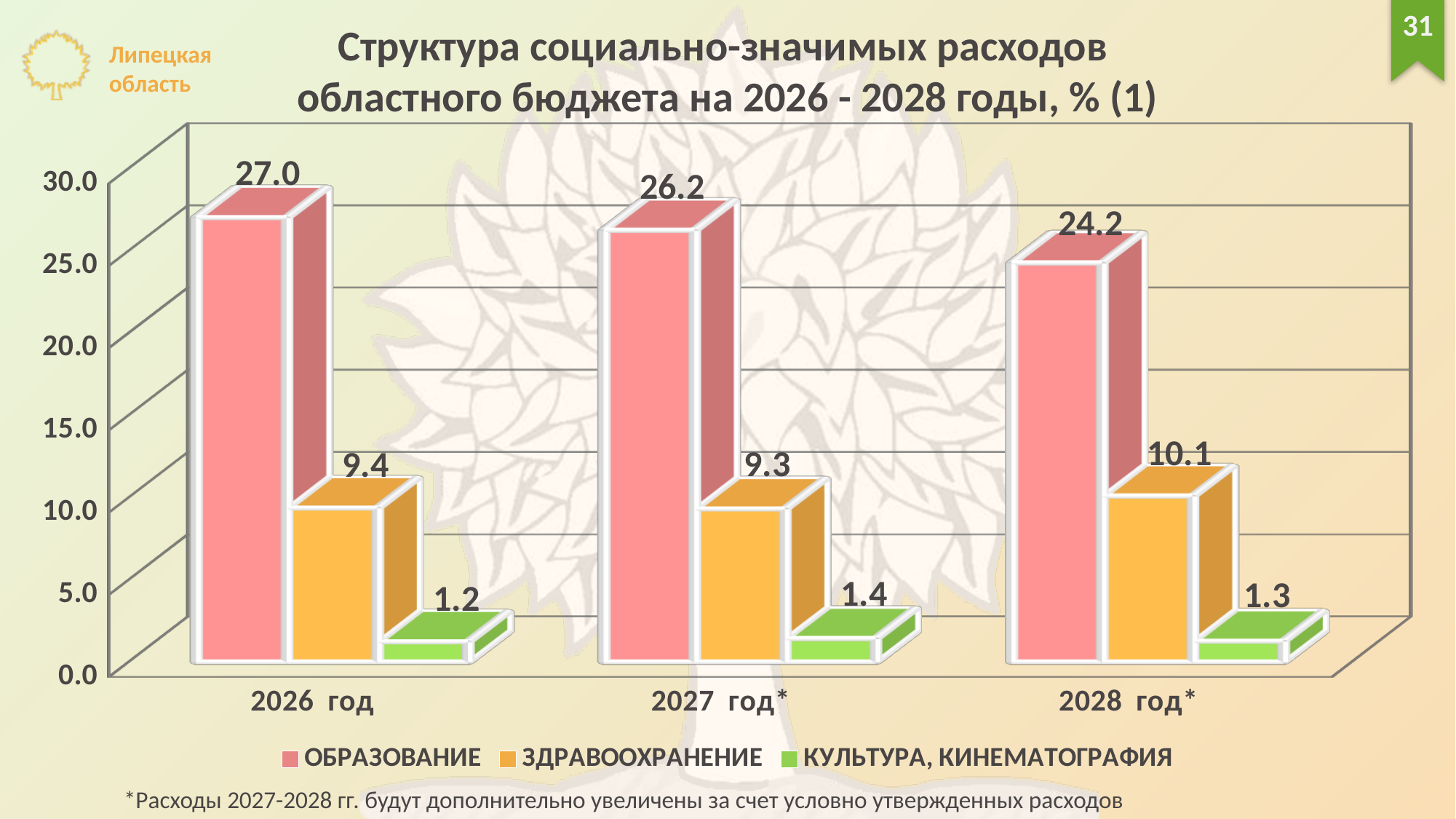
How many years are shown on the x axis? 3 Does the value for ОБРАЗОВАНИЕ rise or fall from 2026 год to 2028 год? fall What is the difference between the ОБРАЗОВАНИЕ values for 2026 год and 2028 год? 2.8 How many series does the legend list? 3 Is the value for ОБРАЗОВАНИЕ in 2027 год greater or less than 25.0? greater Which is larger: ЗДРАВООХРАНЕНИЕ in 2026 год or ЗДРАВООХРАНЕНИЕ in 2027 год? 2026 год In which year is the value for ЗДРАВООХРАНЕНИЕ the highest? 2028 год What is the value for ЗДРАВООХРАНЕНИЕ in 2028 год? 10.1 What kind of chart is shown on the slide? bar chart What is the value for ОБРАЗОВАНИЕ in 2026 год? 27.0 In which year is the value for ОБРАЗОВАНИЕ the lowest? 2028 год What is the value for КУЛЬТУРА, КИНЕМАТОГРАФИЯ in 2027 год? 1.4